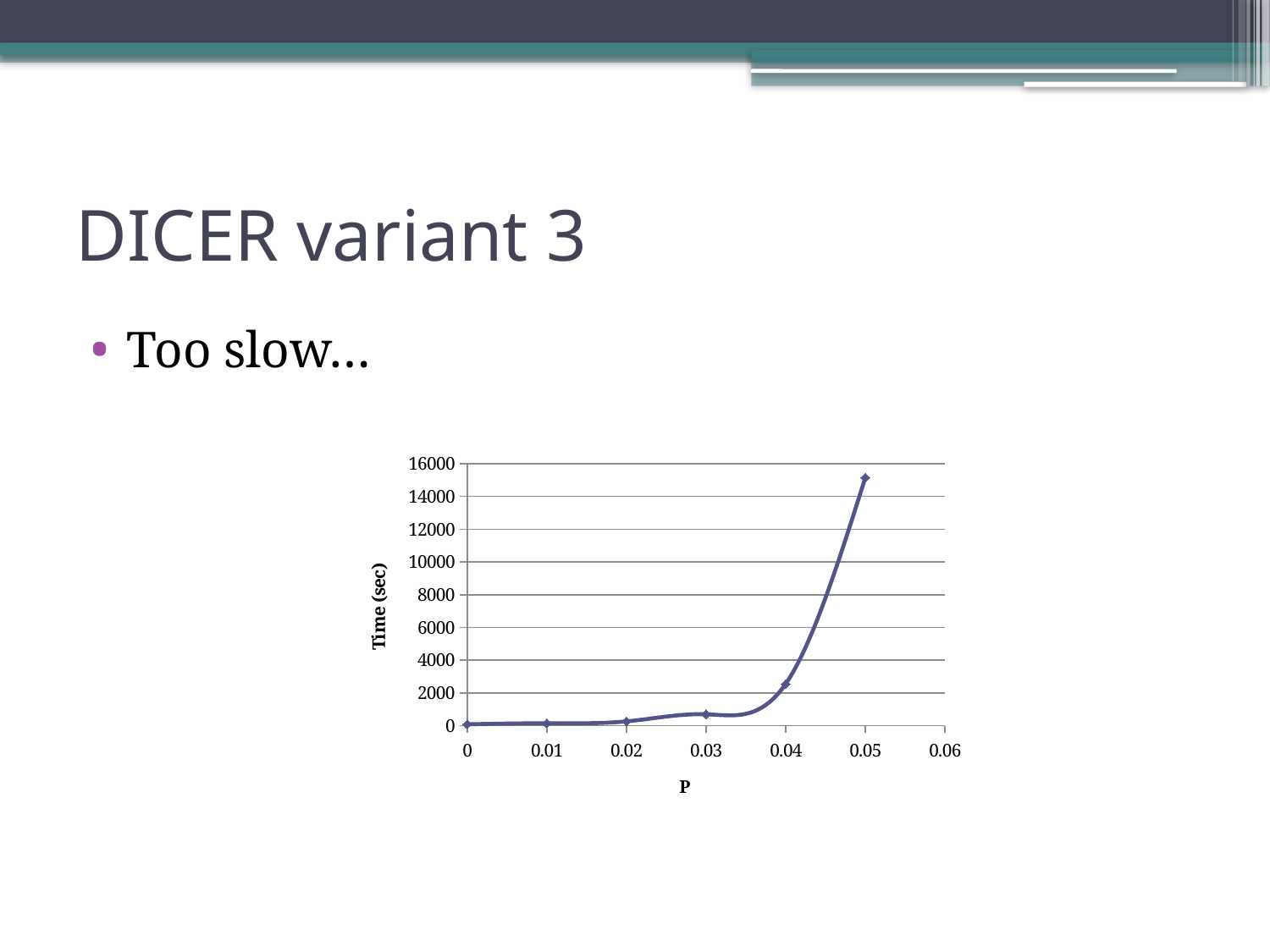
Is the time at P = 0.04 greater or less than 2000? greater Is the time at P = 0.03 greater or less than 2000? less What kind of chart is shown on the slide? line chart What is the label of the vertical axis? Time (sec) Is the time at P = 0.05 greater or less than 14000? greater At which value of P is the time highest? 0.05 Do the time values rise or fall as P increases along the x axis? rise Which has a larger time value, P = 0.04 or P = 0.05? 0.05 Which has a larger time value, P = 0.02 or P = 0.04? 0.04 What is the label of the horizontal axis? P How many data points are plotted on the chart? 6